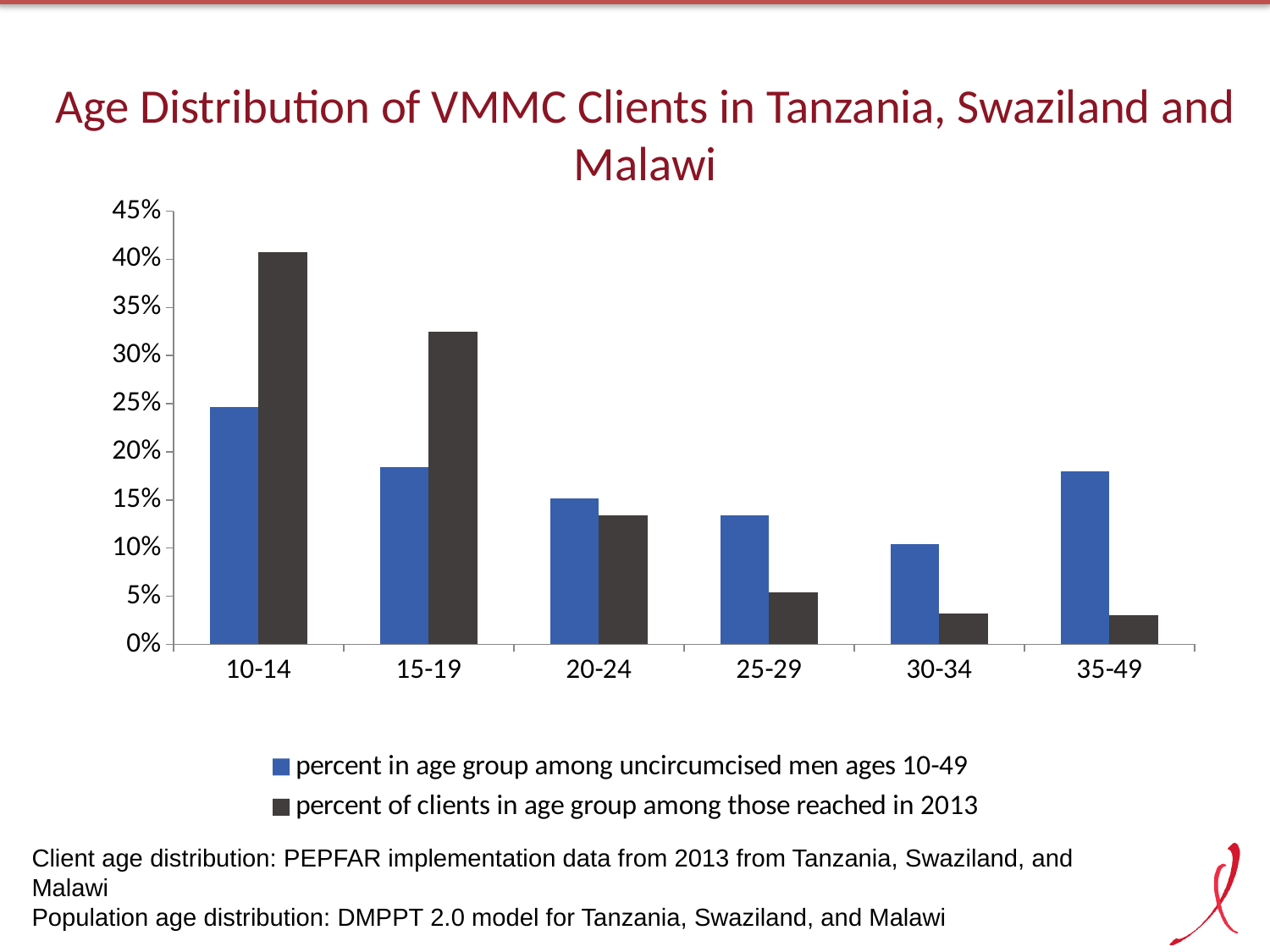
Do the values for 'percent of clients in age group among those reached in 2013' rise or fall as age group increases along the x axis? fall Is the value for 'percent of clients in age group among those reached in 2013' for the 35-49 age group greater or less than 5%? less Is the value for 'percent of clients in age group among those reached in 2013' for the 15-19 age group greater or less than 30%? greater How many series does the legend list? 2 Is the value for 'percent in age group among uncircumcised men ages 10-49' for the 10-14 age group greater or less than 20%? greater For the 25-29 age group, which series has the larger value: 'percent in age group among uncircumcised men ages 10-49' or 'percent of clients in age group among those reached in 2013'? percent in age group among uncircumcised men ages 10-49 Which age group has the highest value for 'percent in age group among uncircumcised men ages 10-49'? 10-14 What kind of chart is shown on the slide? bar chart Which age group has the lowest value for 'percent in age group among uncircumcised men ages 10-49'? 30-34 Which age group has the highest value for 'percent of clients in age group among those reached in 2013'? 10-14 How many age groups are shown on the x axis? 6